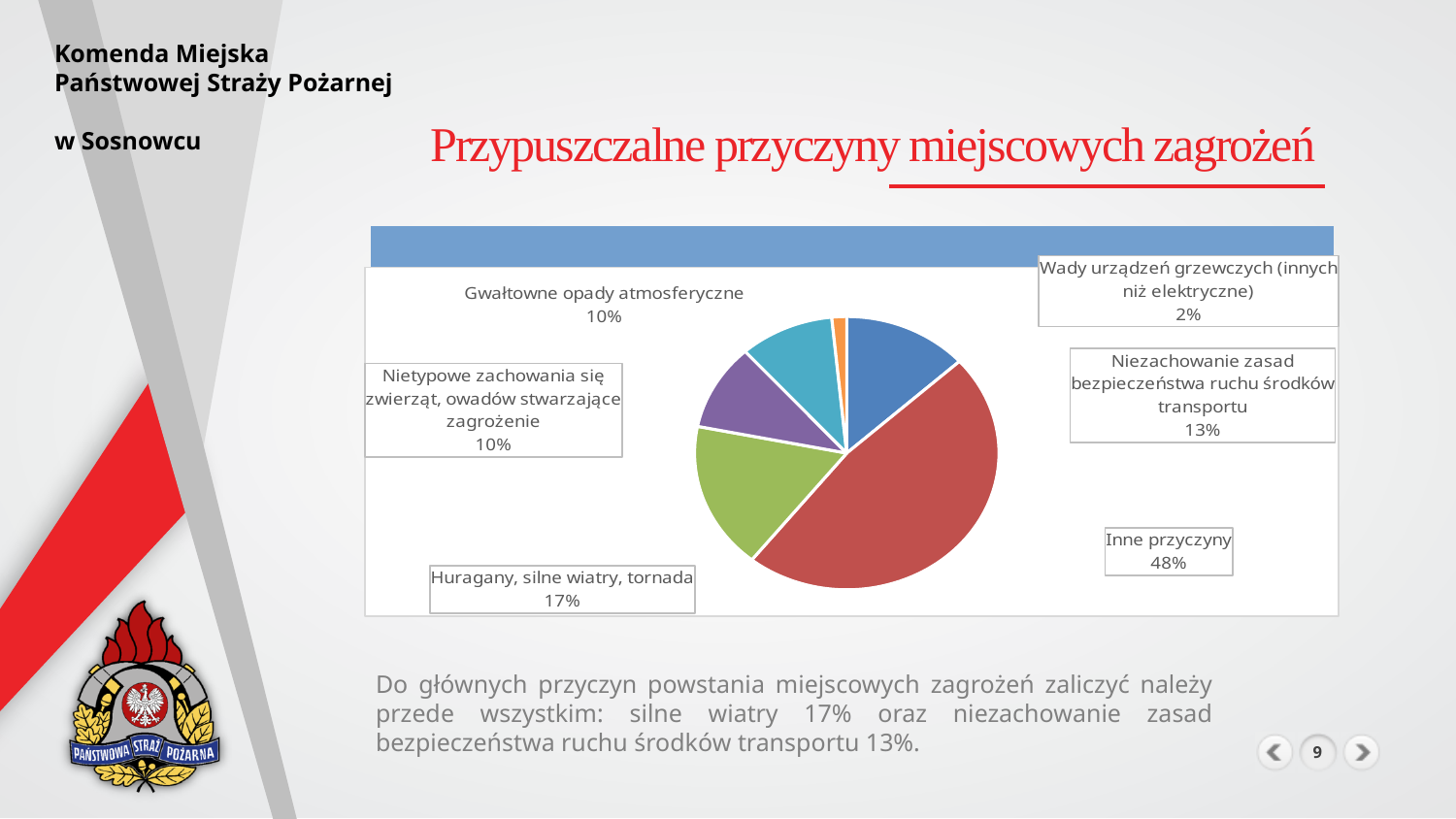
What share of the pie is labelled "Inne przyczyny"? 48% What percentage is shown for "Wady urządzeń grzewczych (innych niż elektryczne)"? 2% How many categories (slices) does the pie chart have? 6 Which category has the largest share of the pie? Inne przyczyny What percentage is shown for "Gwałtowne opady atmosferyczne"? 10% What type of chart is shown on the slide? pie chart What is the difference in percentage points between "Inne przyczyny" and "Huragany, silne wiatry, tornada"? 31 What percentage is shown for "Niezachowanie zasad bezpieczeństwa ruchu środków transportu"? 13% Which is larger: the share for "Huragany, silne wiatry, tornada" or the share for "Niezachowanie zasad bezpieczeństwa ruchu środków transportu"? Huragany, silne wiatry, tornada What is the title of the slide above the chart? Przypuszczalne przyczyny miejscowych zagrożeń What percentage is shown for "Huragany, silne wiatry, tornada"? 17% Which category has the smallest share of the pie? Wady urządzeń grzewczych (innych niż elektryczne)